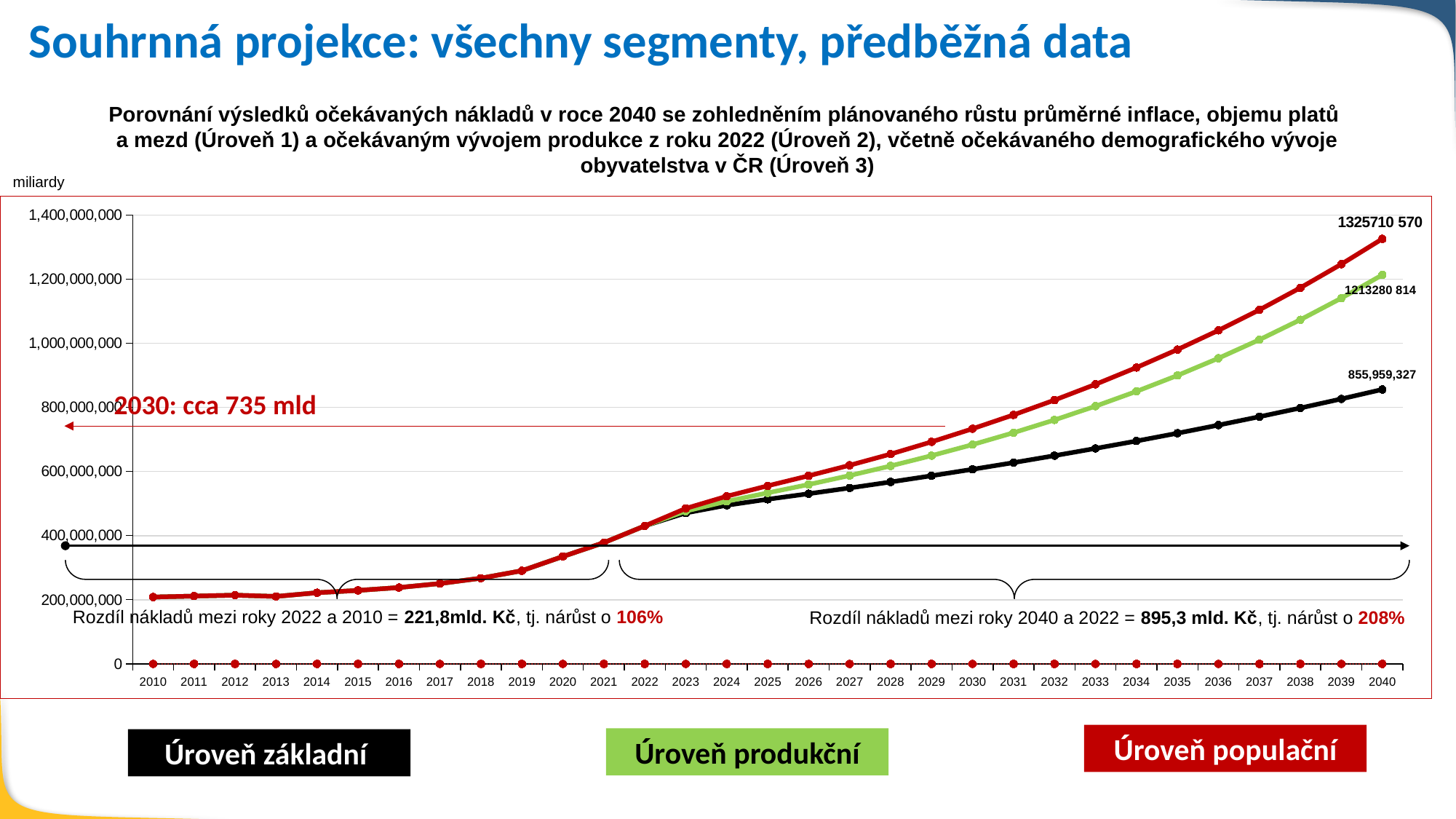
Do the values of the Úroveň populační series rise or fall from 2022 to 2040? rise Which colour is used for the Úroveň základní series in the chart? black Which series has the lowest value in 2040? Úroveň základní What is the value of the Úroveň produkční series in 2040? 1213280 814 In 2040, which is larger: the Úroveň produkční value or the Úroveň základní value? Úroveň produkční What is the value of the Úroveň základní series in 2040? 855,959,327 What kind of chart is shown on the slide? line chart Which series has the highest value in 2040? Úroveň populační How many series does the legend below the chart list? 3 Is the value of the Úroveň produkční series in 2035 greater or less than 1,000,000,000? less What is the value of the Úroveň populační series in 2040? 1325710 570 How many years are plotted along the x axis of the chart? 31